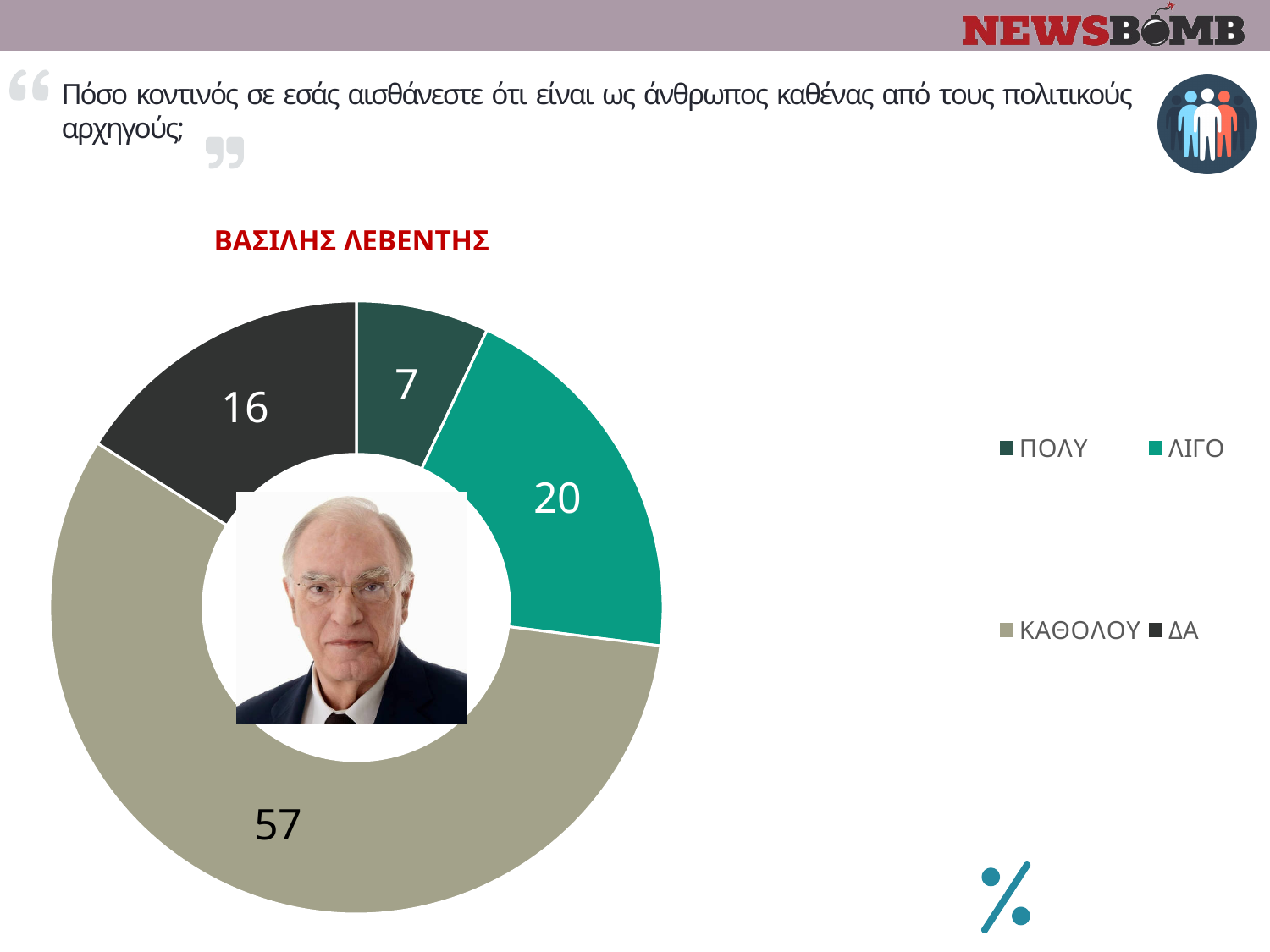
What is the value for ΚΑΘΟΛΟΥ in the ΒΑΣΙΛΗΣ ΛΕΒΕΝΤΗΣ chart? 57 How many entries does the legend list? 4 What is the difference between the values for ΚΑΘΟΛΟΥ and ΛΙΓΟ? 37 Which category has the smallest slice in the chart? ΠΟΛΥ What is the value for ΔΑ in the chart? 16 How many slices does the chart have? 4 Which is larger, the value for ΔΑ or the value for ΠΟΛΥ? ΔΑ Which category has the largest slice in the chart? ΚΑΘΟΛΟΥ What is the value for ΛΙΓΟ in the chart? 20 What is the value for ΠΟΛΥ in the chart? 7 What type of chart is shown on the slide? Doughnut (pie) chart What is the title of the chart? ΒΑΣΙΛΗΣ ΛΕΒΕΝΤΗΣ